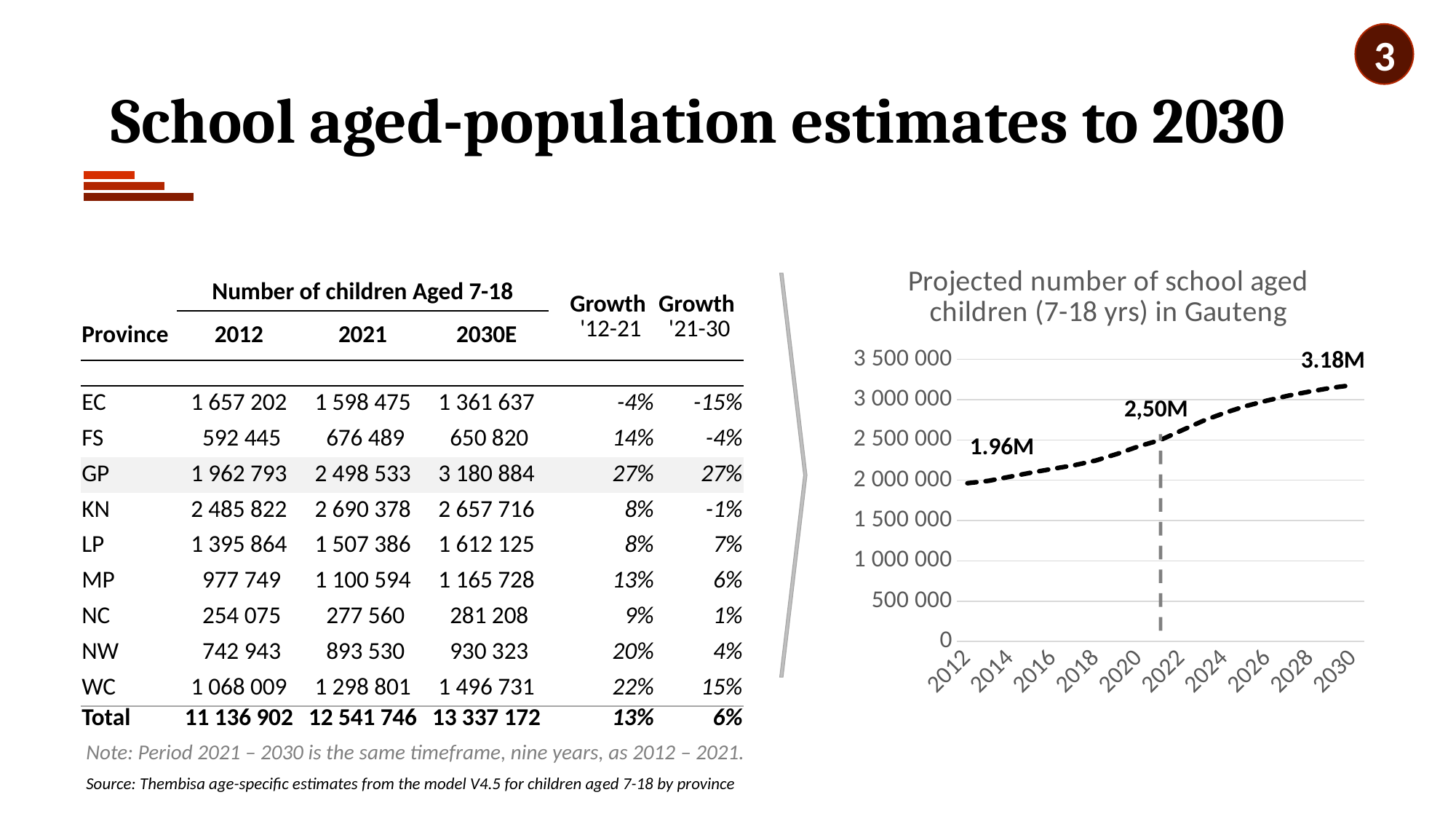
Does the projected number of school aged children in Gauteng rise or fall from 2012 to 2030? Rise How many data labels are printed on the chart's line? 3 What value is labelled on the chart for 2012? 1.96M Which year has the highest value on the chart? 2030 Which year has the lowest value on the chart? 2012 Is the value for 2026 greater or less than 2 500 000? greater What value is labelled on the chart for 2030? 3.18M What is the title of the chart on the slide? Projected number of school aged children (7-18 yrs) in Gauteng What kind of chart is shown on the slide? Line chart What is the highest tick value shown on the chart's vertical axis? 3 500 000 What value is labelled on the chart at the point where the dashed vertical line crosses the series (around 2021)? 2,50M Is the value for 2016 greater or less than 2 500 000? less